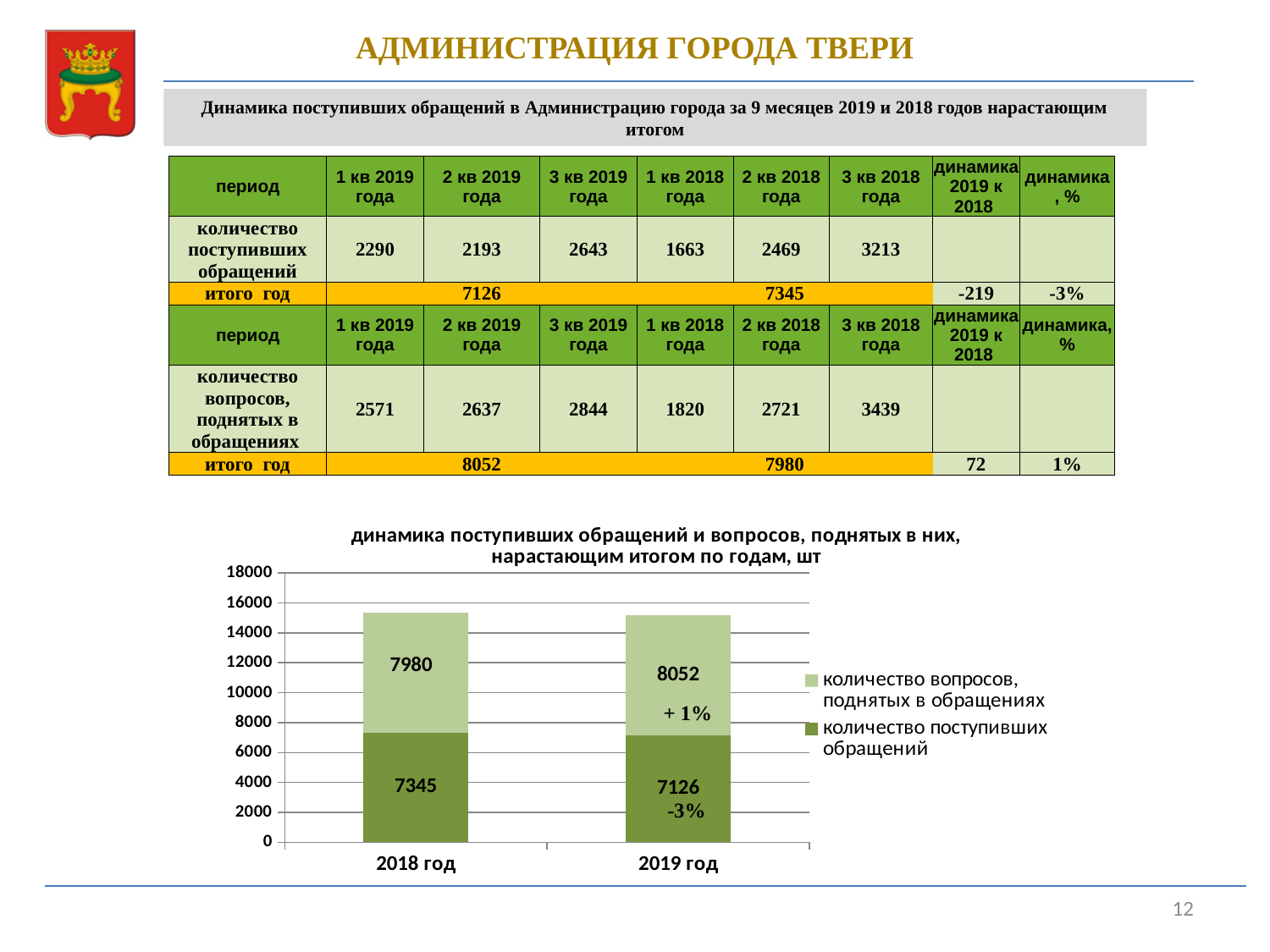
What is the value of 'количество поступивших обращений' for 2019 год in the chart? 7126 What is the difference between 'количество вопросов, поднятых в обращениях' in 2019 год and 2018 год? 72 Which year has the larger value for 'количество поступивших обращений', 2018 год or 2019 год? 2018 год How many categories are shown on the x axis of the chart? 2 What is the total of the stacked bar for 2018 год? 15325 What is the total of the stacked bar for 2019 год? 15178 Which series is shown in the darker green colour in the chart? количество поступивших обращений What is the value of 'количество поступивших обращений' for 2018 год in the chart? 7345 What is the value of 'количество вопросов, поднятых в обращениях' for 2019 год in the chart? 8052 What is the value of 'количество вопросов, поднятых в обращениях' for 2018 год in the chart? 7980 What kind of chart is shown on the slide? stacked bar chart How many series does the chart legend list? 2